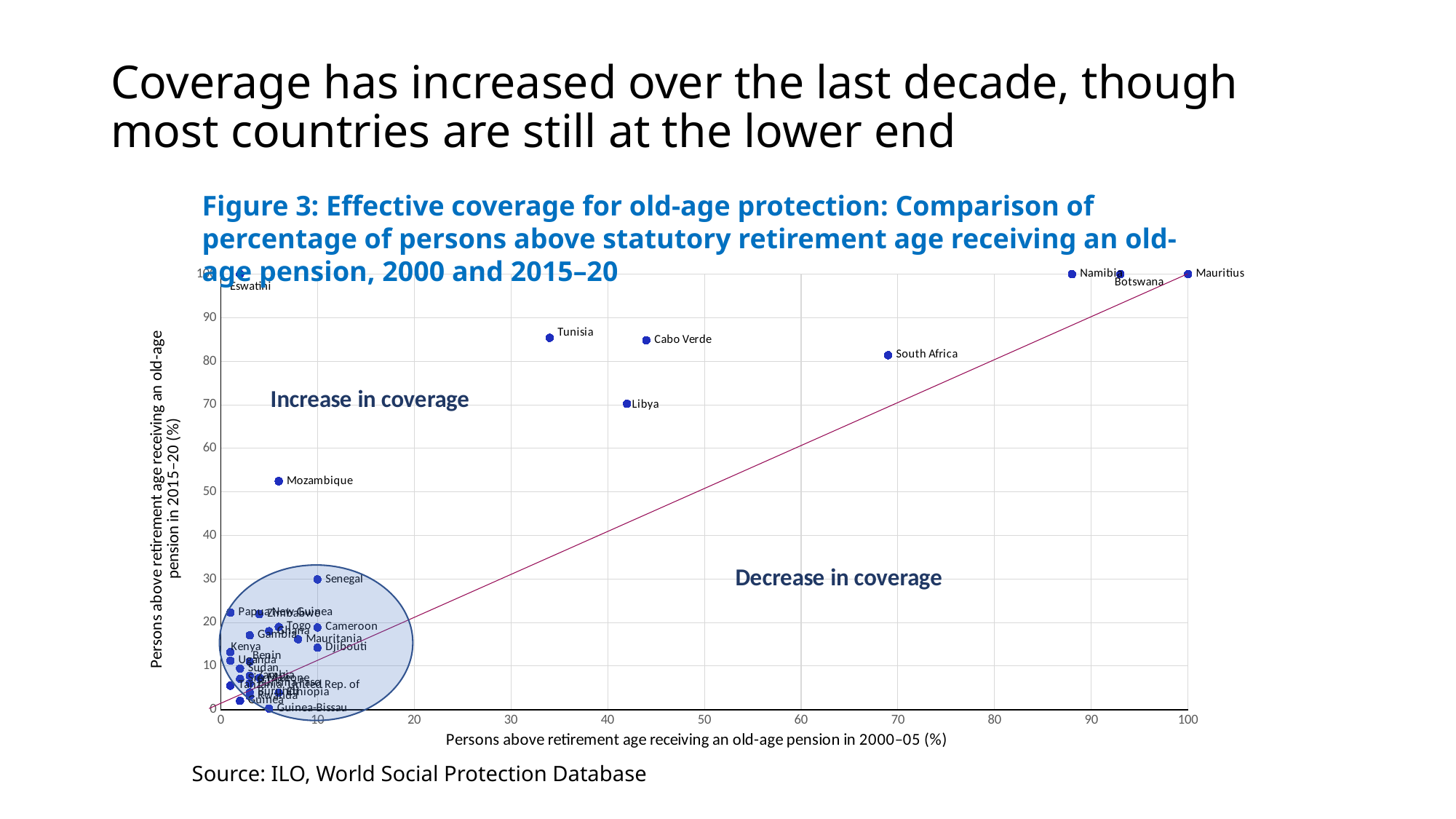
What text is written in the region above the diagonal line? Increase in coverage What is the label of the x axis? Persons above retirement age receiving an old-age pension in 2000–05 (%) Which country has the highest 2000–05 coverage value on the chart? Mauritius Is the 2000–05 coverage value for Tunisia greater or less than 30? greater Is the 2015–20 coverage value for Cabo Verde greater or less than 80? greater Is the 2000–05 coverage value for South Africa greater or less than 60? greater Which has the higher 2015–20 coverage value, Libya or South Africa? South Africa Which has the higher 2000–05 coverage value, Mozambique or Tunisia? Tunisia What kind of chart is shown on the slide? Scatter chart